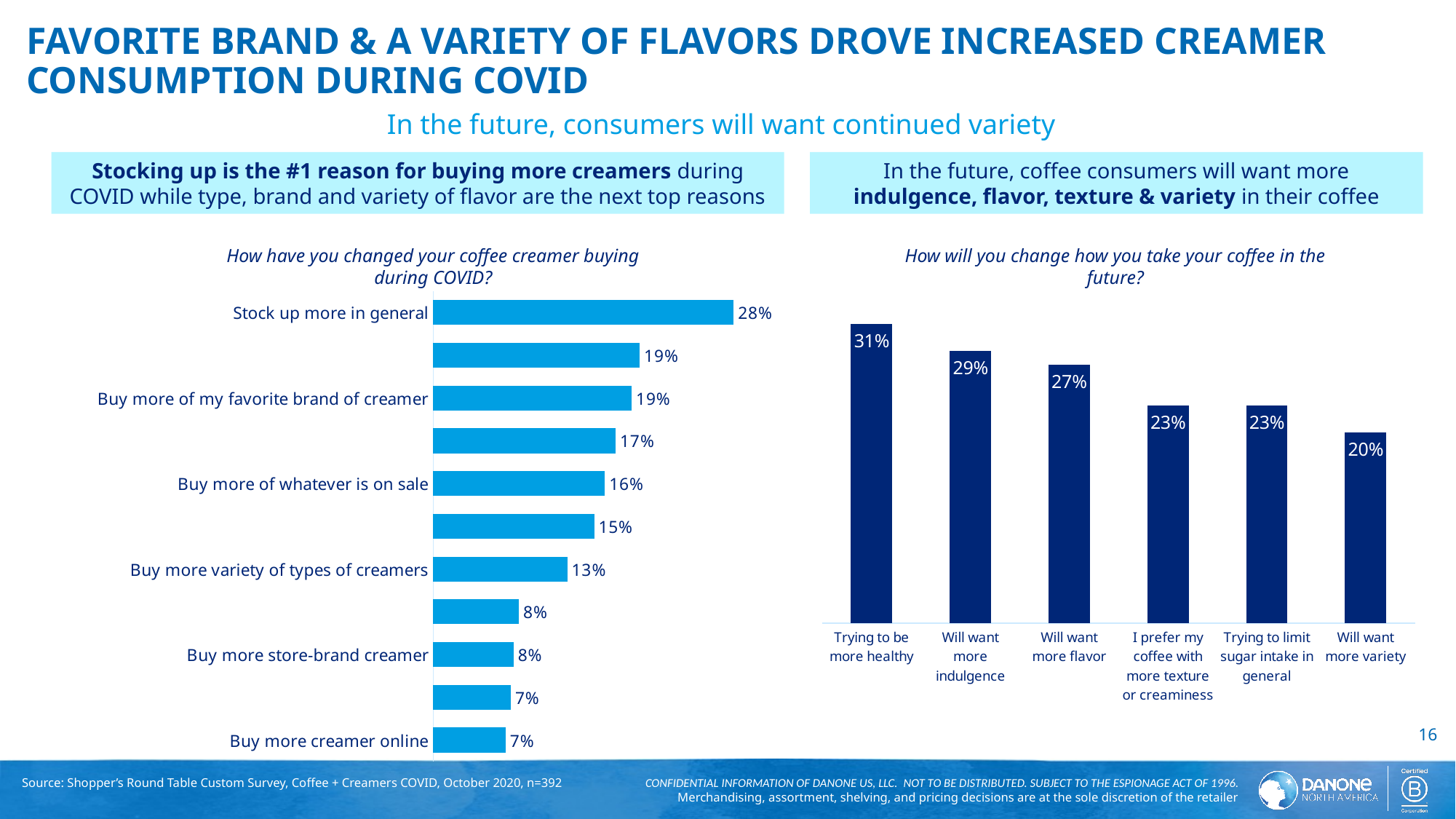
In the chart 'How will you change how you take your coffee in the future?', how many categories are shown? 6 What kind of chart is 'How have you changed your coffee creamer buying during COVID?'? Bar chart In the chart 'How have you changed your coffee creamer buying during COVID?', what is the value for 'Buy more of my favorite brand of creamer'? 19% In the chart 'How have you changed your coffee creamer buying during COVID?', how many bars are plotted? 11 In the chart 'How have you changed your coffee creamer buying during COVID?', what is the difference between 'Buy more of whatever is on sale' and 'Buy more variety of types of creamers'? 3% In the chart 'How will you change how you take your coffee in the future?', what is the value for 'Will want more indulgence'? 29% In the chart 'How have you changed your coffee creamer buying during COVID?', what is the value for 'Buy more creamer online'? 7% In the chart 'How will you change how you take your coffee in the future?', which is larger: 'Trying to be more healthy' or 'Will want more flavor'? Trying to be more healthy In the chart 'How will you change how you take your coffee in the future?', which category has the lowest value? Will want more variety In the chart 'How have you changed your coffee creamer buying during COVID?', what is the value for 'Stock up more in general'? 28% In the chart 'How have you changed your coffee creamer buying during COVID?', which category has the highest value? Stock up more in general In the chart 'How will you change how you take your coffee in the future?', what is the difference between 'Trying to be more healthy' and 'Will want more variety'? 11%